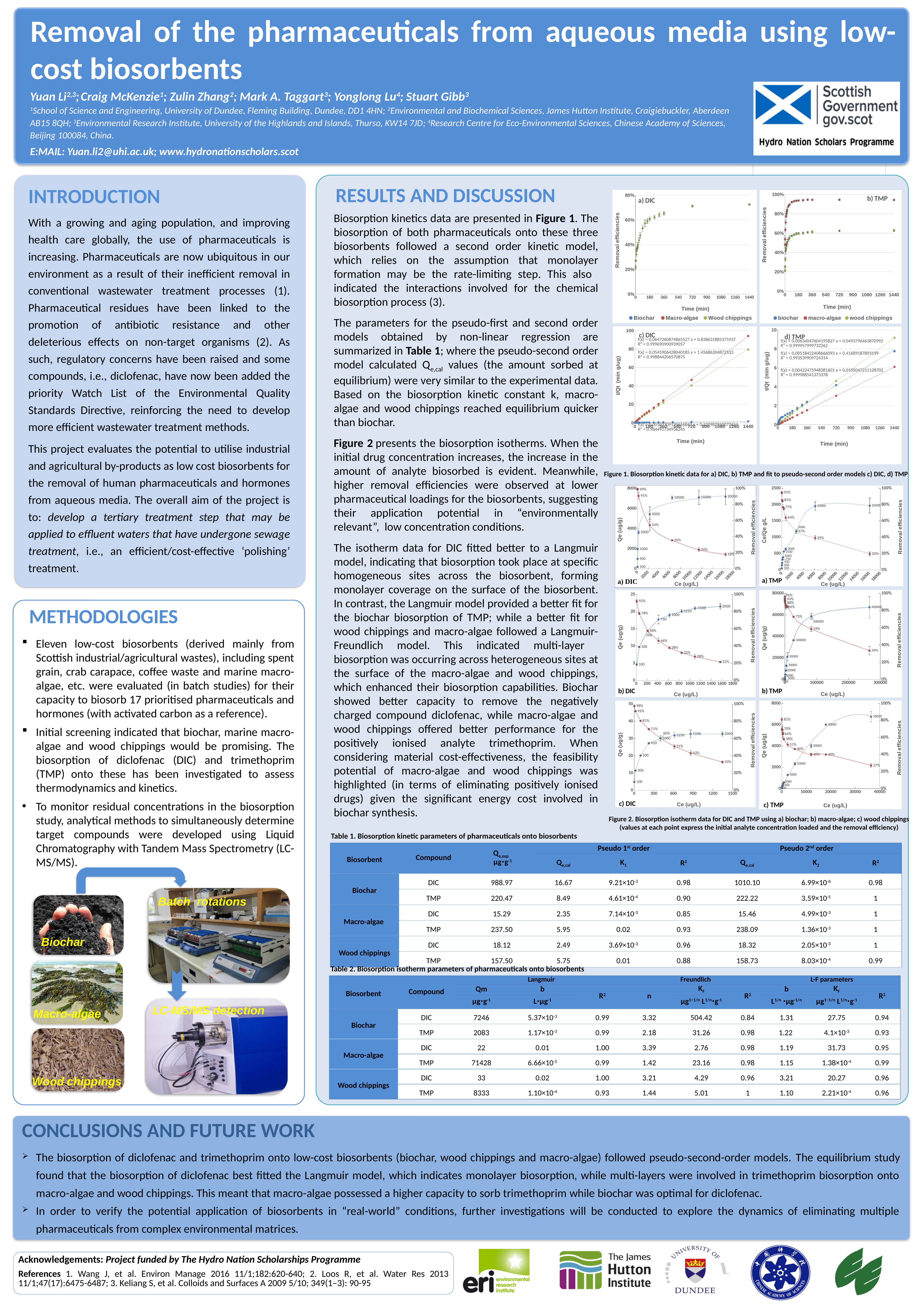
In Figure 1 a) DIC, how many series does the legend list? 3 In Figure 2 b) DIC, does the labelled removal efficiency rise or fall as Ce increases? fall In Figure 2 c) TMP, what is the lowest removal efficiency labelled on the points? 27% In Figure 2 a) DIC, what is the highest removal efficiency labelled on the points? 99% In Figure 2 c) DIC, what is the lowest removal efficiency labelled on the points? 33% In Figure 1 c) DIC, does t/Qt rise or fall as time increases? rise What kind of chart is Figure 1 a) DIC? scatter chart In Figure 2 c) DIC, what is the difference between the highest and lowest labelled removal efficiencies? 65% In Figure 1 a) DIC, do the removal efficiencies rise or fall as time increases? rise In Figure 1 a) DIC, what are the legend entries? Biochar, Macro-algae, Wood chippings In Figure 2 b) DIC, what is the lowest removal efficiency labelled on the points? 22% In Figure 2 c) DIC, what is the highest removal efficiency labelled on the points? 98%